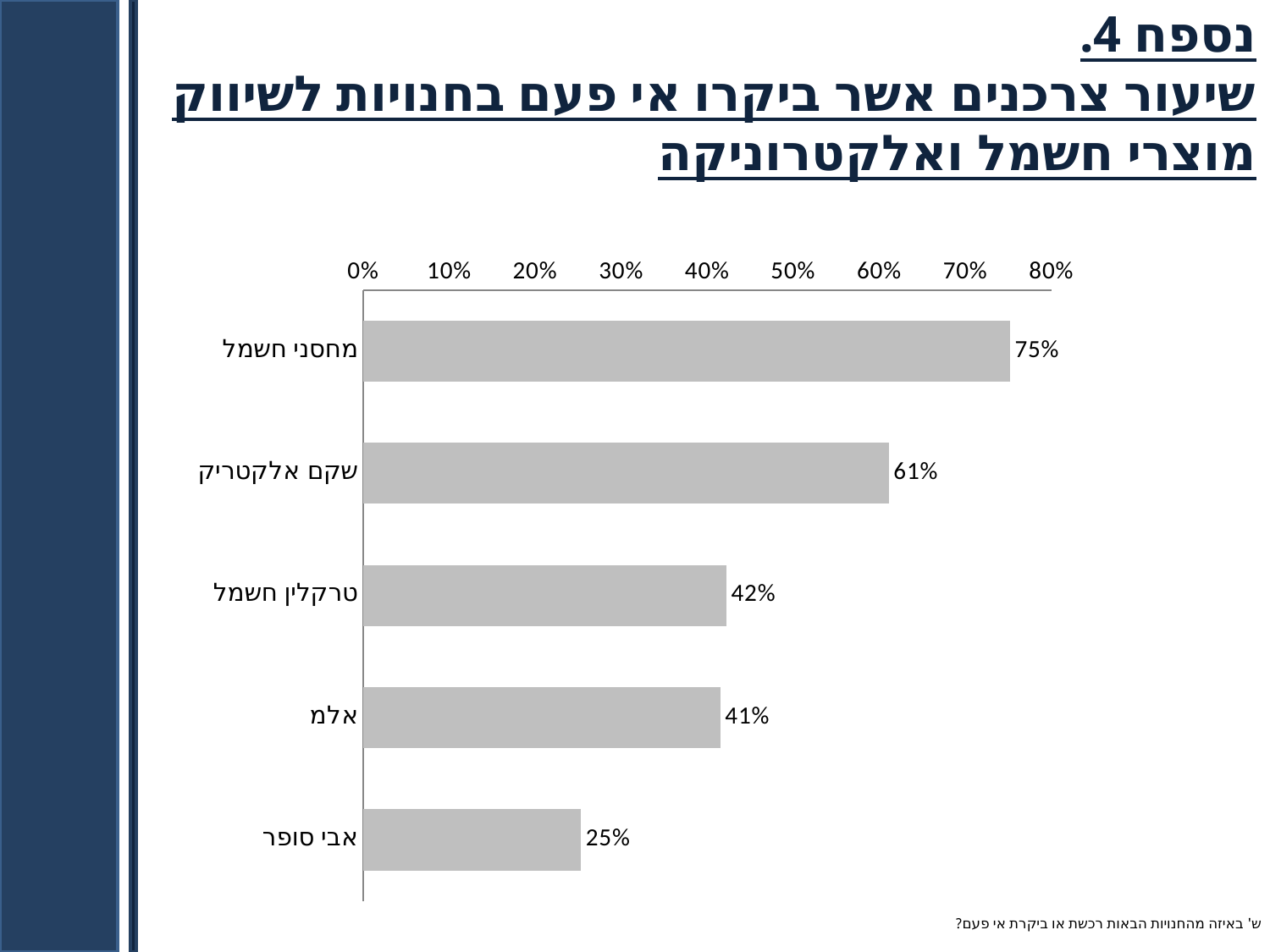
Which is larger, the value for שקם אלקטריק or the value for אלמ? שקם אלקטריק Which category has the highest value? מחסני חשמל What is the value for טרקלין חשמל? 42% What kind of chart is shown on the slide? bar chart Which category has the lowest value? אבי סופר What is the value for מחסני חשמל? 75% What is the value for שקם אלקטריק? 61% What is the value for אבי סופר? 25% Is the value for אלמ greater or less than 50%? less What is the difference between the values for טרקלין חשמל and אבי סופר? 17% What is the difference between the values for מחסני חשמל and שקם אלקטריק? 14% How many categories are shown in the chart? 5